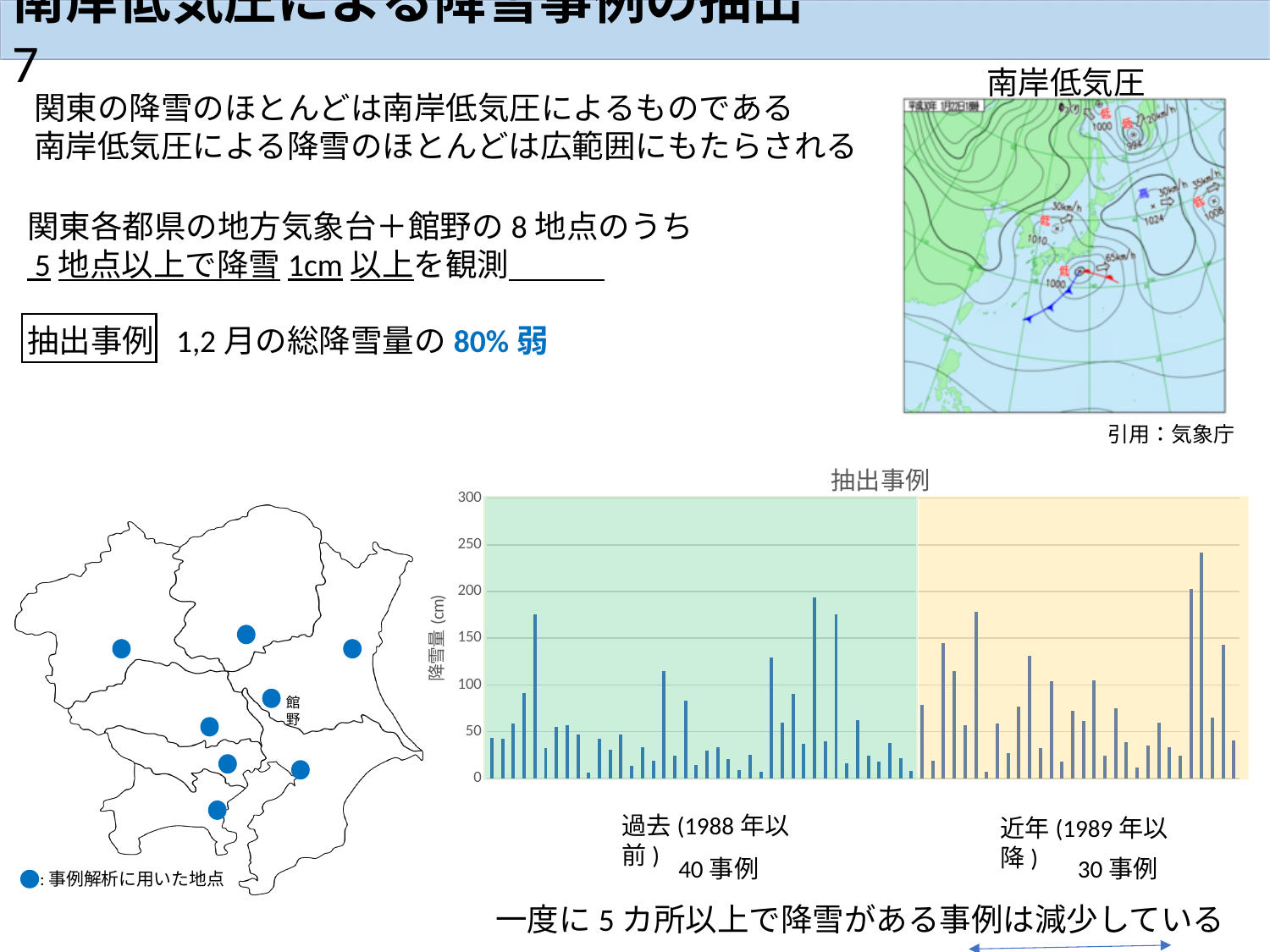
What is the interval between consecutive tick marks on the vertical axis of the bar chart? 50 Which period has more cases in the bar chart, the past (1988年以前) or the recent (1989年以降)? past (1988年以前) How many cases (bars) are in the past period (1988年以前) of the bar chart? 40 Which shaded region of the chart contains the tallest bar, the green (past) region or the yellow (recent) region? yellow (recent) region Is the tallest bar in the chart greater or less than 250? less What kind of chart is shown at the bottom right of the slide? bar chart What is the title of the bar chart? 抽出事例 What is the label of the vertical axis of the bar chart? 降雪量 (cm) Is the tallest bar in the green-shaded (past) region greater or less than 150? greater What is the maximum value shown on the vertical axis of the bar chart? 300 Is the tallest bar in the chart greater or less than 200? greater How many cases (bars) are in the recent period (1989年以降) of the bar chart? 30